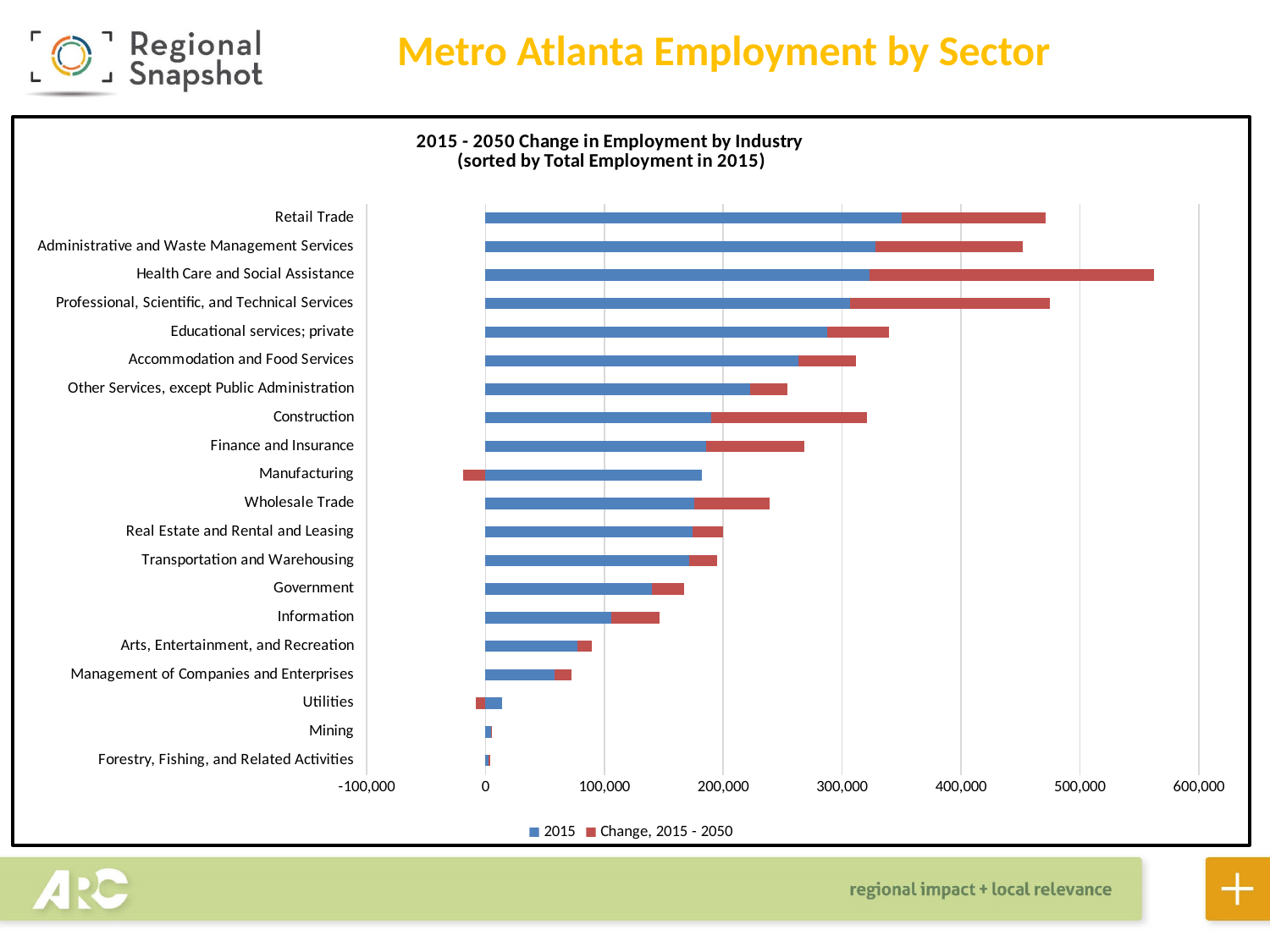
What are the two series named in the legend? 2015 and Change, 2015 - 2050 What is the title of the chart? 2015 - 2050 Change in Employment by Industry (sorted by Total Employment in 2015) Is the 2015 value for Manufacturing greater or less than 200,000? less Is the 2015 value for Arts, Entertainment, and Recreation greater or less than 100,000? less Which industry has the longest total bar (2015 plus change) on the chart? Health Care and Social Assistance Which has the larger Change, 2015 - 2050 bar: Health Care and Social Assistance or Retail Trade? Health Care and Social Assistance How many industries are listed on the chart? 20 Which industry shows a negative change for 2015 - 2050 with a red bar extending left of zero and the largest such decline? Manufacturing Is the 2015 value for Retail Trade greater or less than 300,000? greater How many series does the legend list? 2 What kind of chart is shown on the slide? Stacked horizontal bar chart